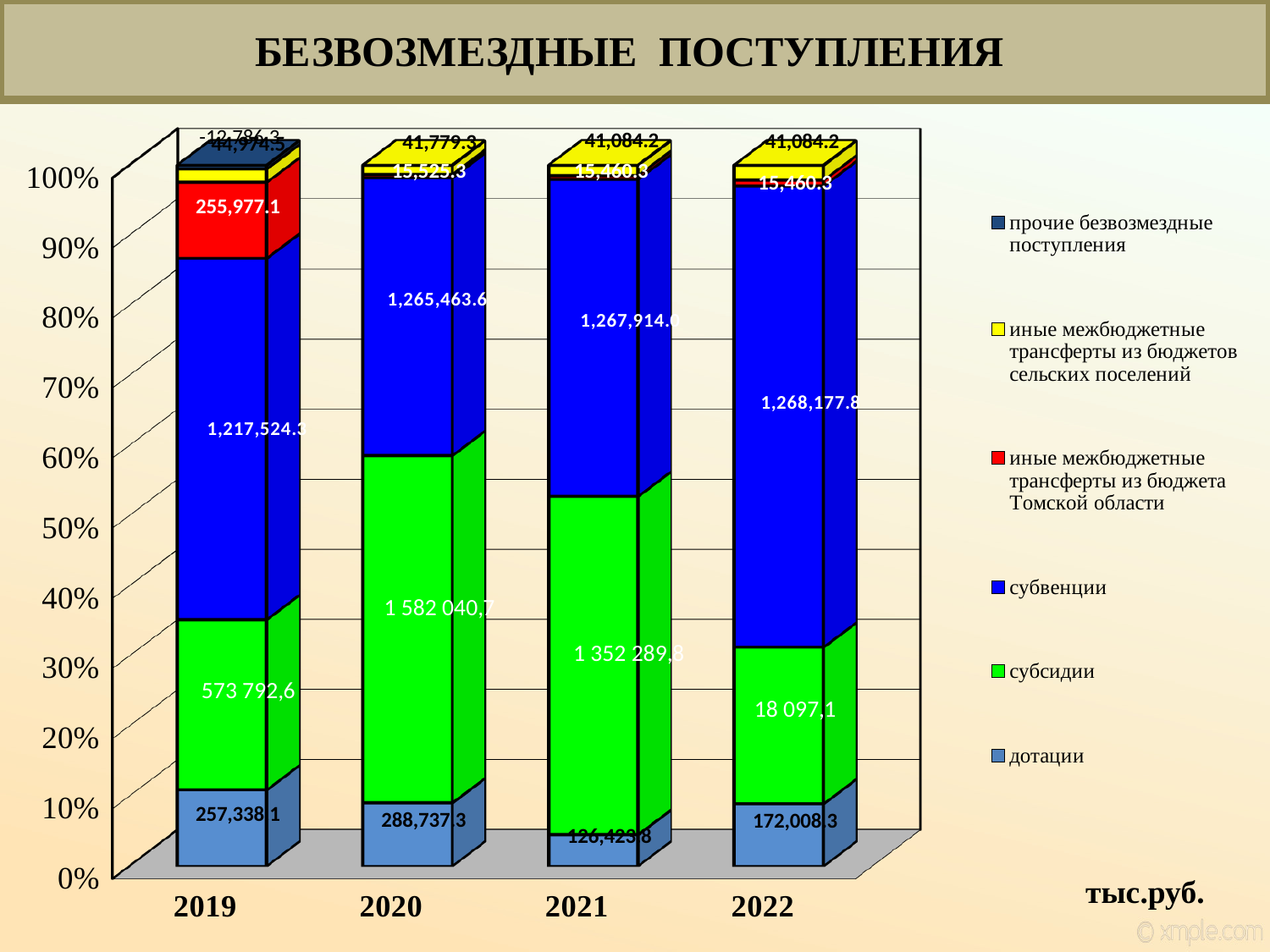
In which year is the value of дотации the lowest? 2021 What kind of chart is shown on the slide? stacked bar chart What is the value of субвенции for 2020? 1,265,463.6 What is the value of дотации for 2019? 257,338.1 What is the value of субвенции for 2022? 1,268,177.8 How many years are shown on the x axis of the chart? 4 In which year is the value of дотации the highest? 2020 How many series does the legend list? 6 Which year has the larger value of субсидии, 2020 or 2021? 2020 What is the value of субсидии for 2021? 1 352 289,8 What is the difference between the дотации values for 2020 and 2019? 31,399.2